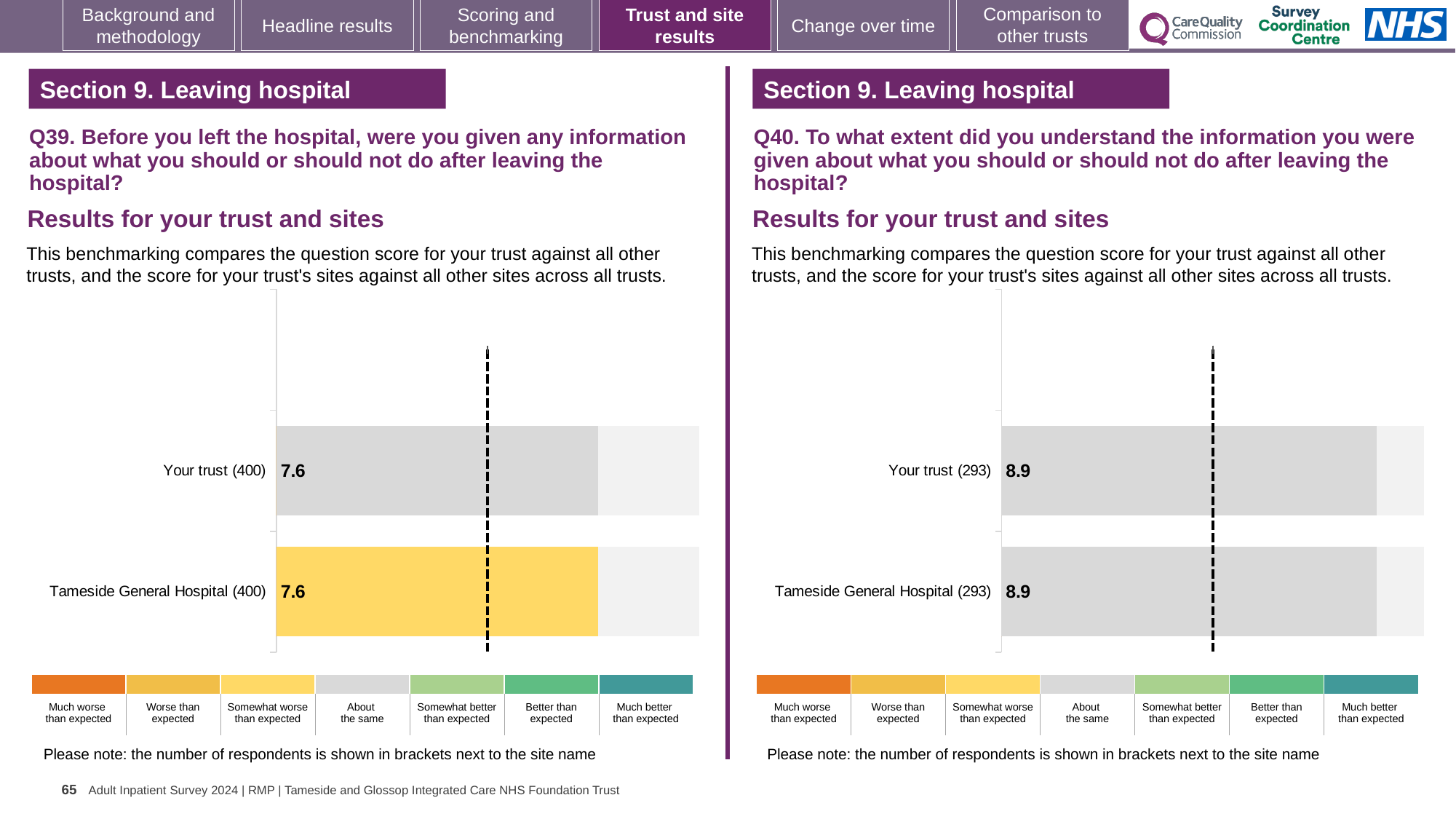
In the Q39 chart on the left, what is the score for Your trust? 7.6 How many bars are plotted in the Q40 chart on the right? 2 In the Q40 chart on the right, what is the difference between the score for Your trust and the score for Tameside General Hospital? 0 In the Q40 chart on the right, how many respondents are shown in brackets next to Your trust? 293 In the Q40 chart on the right, what is the score for Tameside General Hospital? 8.9 In the Q39 chart on the left, what is the difference between the score for Your trust and the score for Tameside General Hospital? 0 In the Q40 chart on the right, what is the score for Your trust? 8.9 How many bars are plotted in the Q39 chart on the left? 2 In the Q39 chart on the left, how many respondents are shown in brackets next to Tameside General Hospital? 400 In the Q39 chart on the left, what is the score for Tameside General Hospital? 7.6 Is the score for Tameside General Hospital in the Q40 chart on the right larger than its score in the Q39 chart on the left? Yes What kind of chart is the Q39 chart on the left? Bar chart